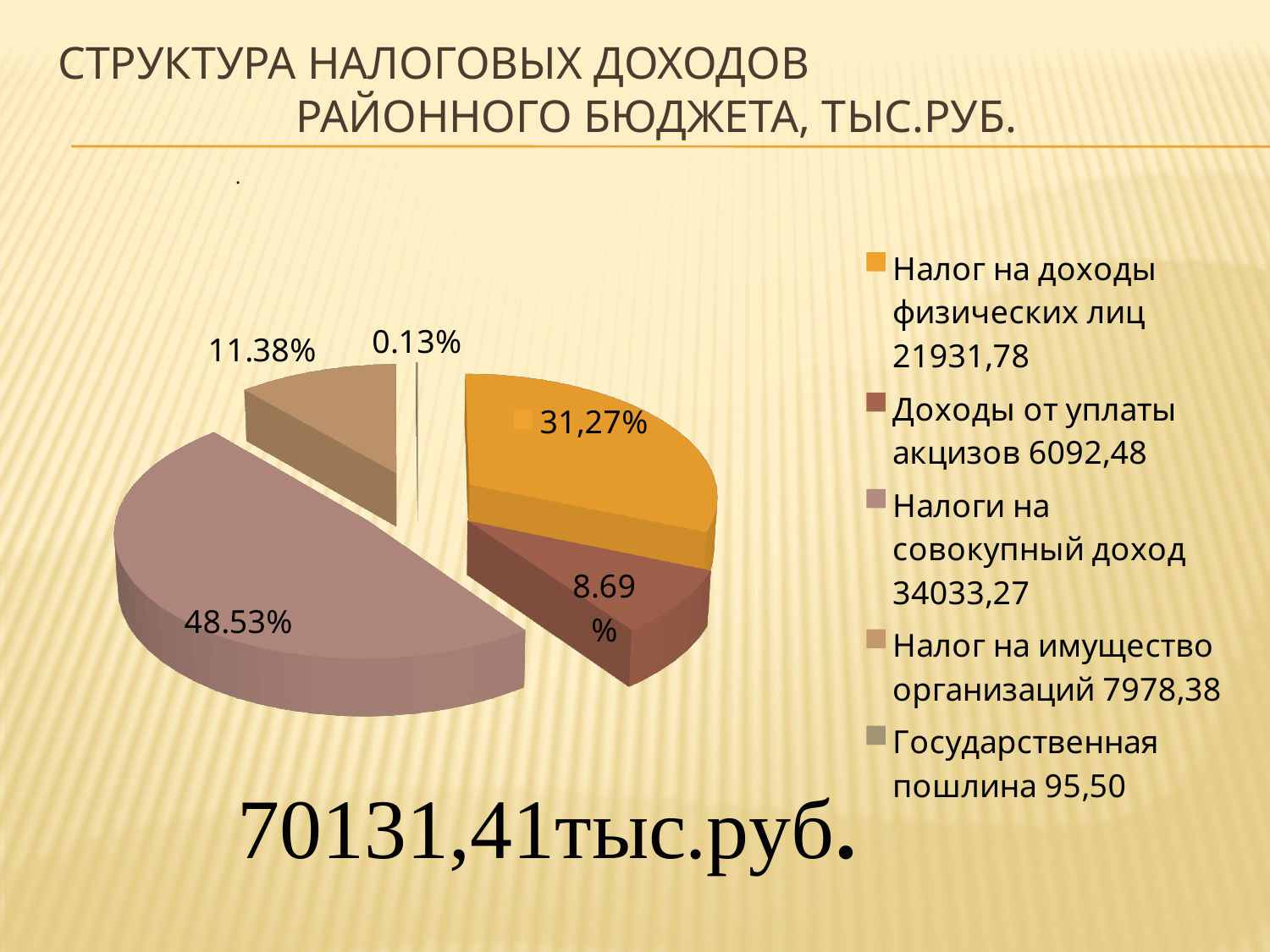
What percentage share is shown for the slice 'Государственная пошлина'? 0.13% Which category has the largest slice of the pie? Налоги на совокупный доход What value is given in the legend for 'Доходы от уплаты акцизов'? 6092,48 What percentage share is shown for the slice 'Налоги на совокупный доход'? 48.53% Which category has the smallest slice of the pie? Государственная пошлина What percentage share is shown for the slice 'Налог на имущество организаций'? 11.38% How many slices does the pie chart have? 5 What kind of chart is shown on the slide? pie chart How many entries does the legend list? 5 Which is larger: the share for 'Налог на имущество организаций' or the share for 'Доходы от уплаты акцизов'? Налог на имущество организаций